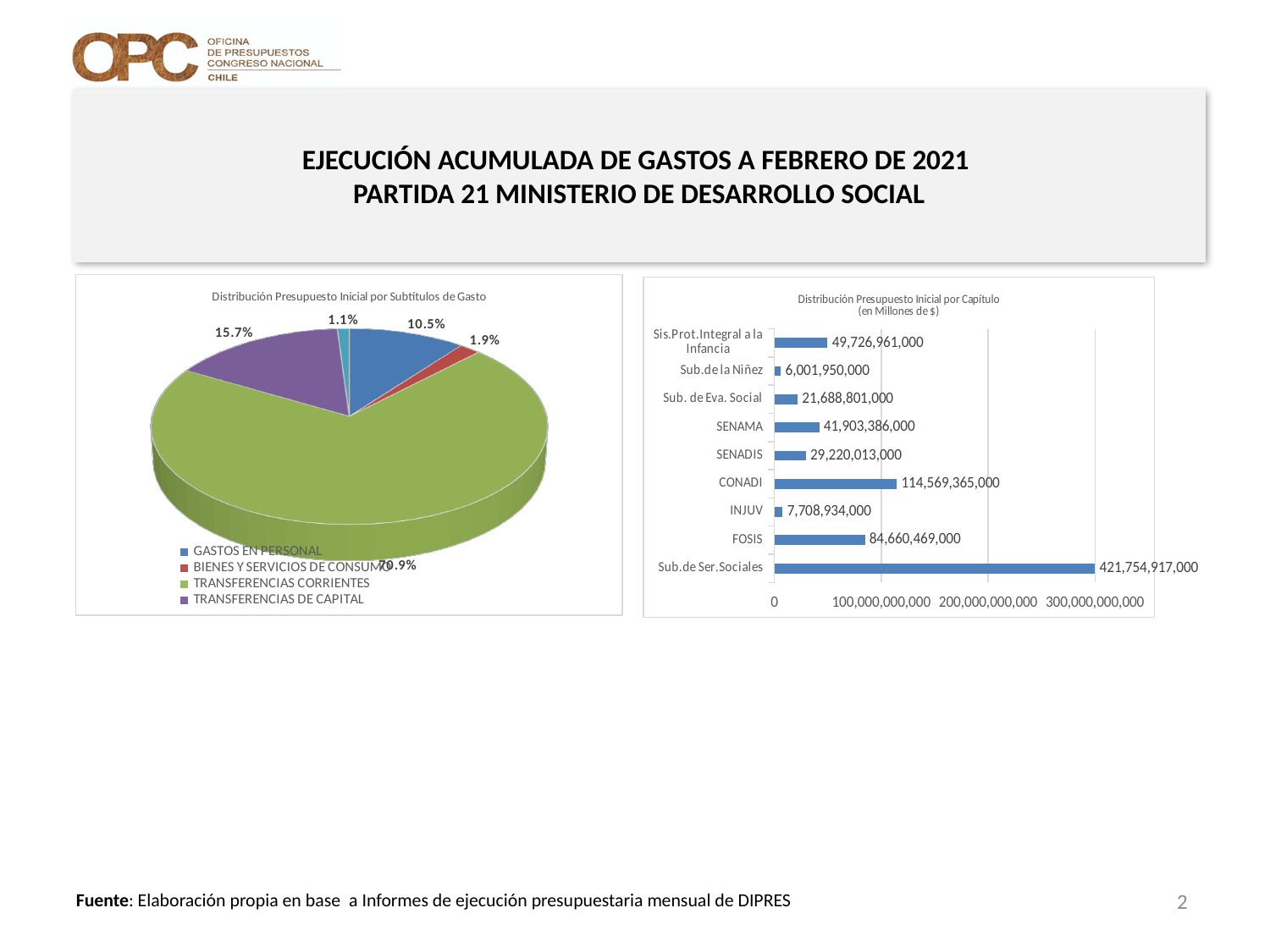
What kind of chart is the chart on the right? Bar chart In the bar chart on the right, which category has the lowest value? Sub.de la Niñez In the pie chart on the left, how many entries does the legend list? 4 In the bar chart on the right, what is the value for FOSIS? 84,660,469,000 In the bar chart on the right, what is the difference between SENAMA and SENADIS? 12,683,373,000 In the pie chart on the left, what share does TRANSFERENCIAS CORRIENTES have? 70.9% In the pie chart on the left, what share does GASTOS EN PERSONAL have? 10.5% In the bar chart on the right, what is the value for CONADI? 114,569,365,000 In the bar chart on the right, which category has the highest value? Sub.de Ser.Sociales In the bar chart on the right, how many categories are shown? 9 In the pie chart on the left, which legend category has the largest slice? TRANSFERENCIAS CORRIENTES In the pie chart on the left, what share does TRANSFERENCIAS DE CAPITAL have? 15.7%